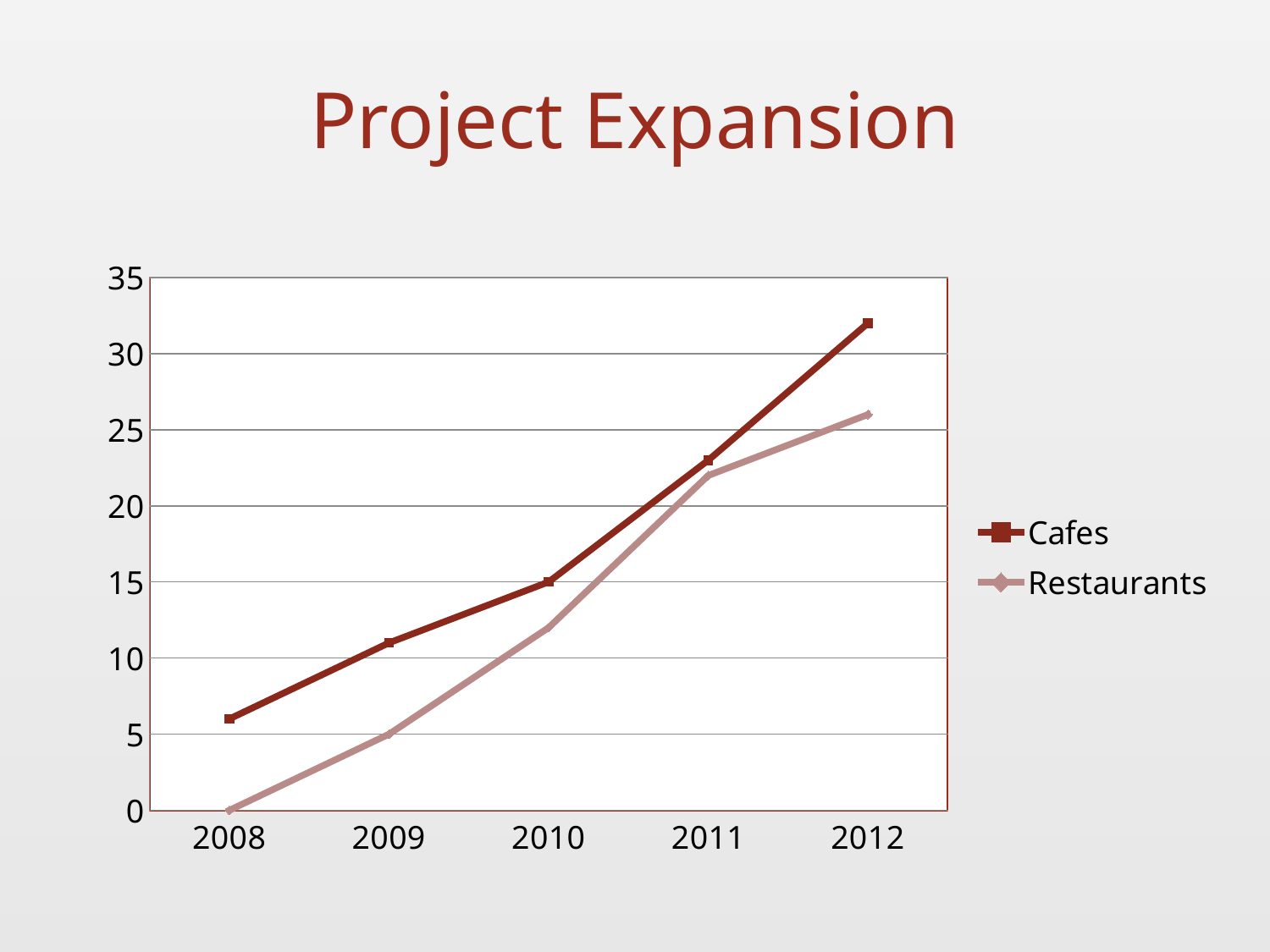
Which year has the highest value for Cafes? 2012 Is the value for Cafes in 2012 greater or less than 30? greater What is the title of the chart? Project Expansion Do the values for Restaurants rise or fall from 2008 to 2012? rise What is the value for Cafes in 2010? 15 Is the value for Restaurants in 2012 greater or less than 30? less What is the value for Restaurants in 2009? 5 What kind of chart is shown on the slide? line chart How many years are shown on the x axis? 5 How many series does the legend list? 2 Is the value for Cafes in 2008 greater or less than 10? less What is the value for Restaurants in 2008? 0